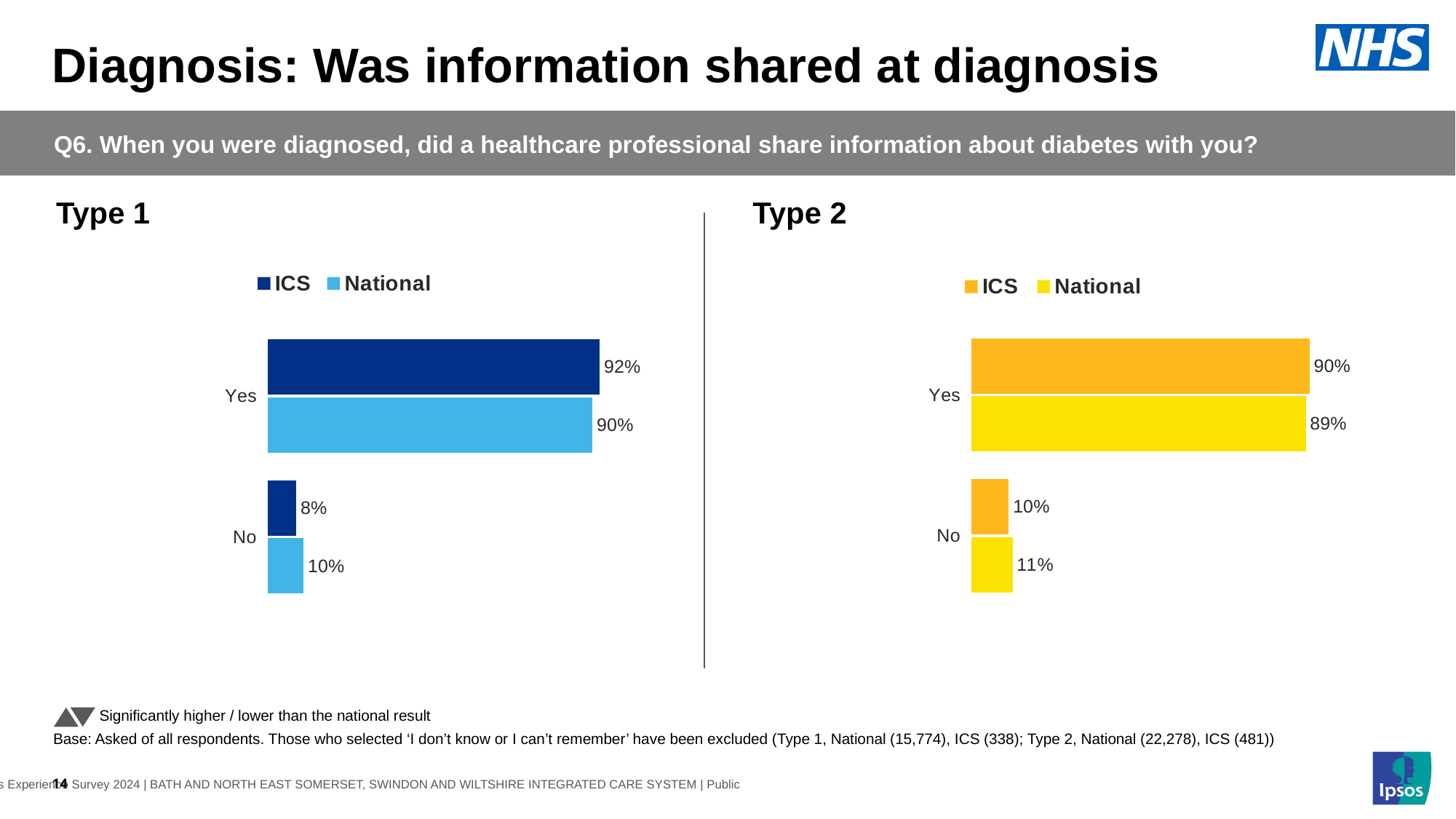
In the Type 1 chart, what is the National value for No? 10% In the Type 2 chart, what is the difference between the National and ICS values for No? 1 percentage point How many categories are shown in the Type 1 chart? 2 In the Type 1 chart, what is the difference between the ICS and National values for Yes? 2 percentage points How many series does the legend of the Type 2 chart list? 2 In the Type 2 chart, what is the ICS value for Yes? 90% In the Type 1 chart, what is the ICS value for Yes? 92% In the Type 2 chart, which is larger for Yes: the ICS value or the National value? ICS In the Type 1 chart, which category has the lowest ICS value? No What kind of chart is the Type 2 chart? Bar chart In the Type 2 chart, what is the National value for No? 11% In the Type 1 chart, which is larger for No: the ICS value or the National value? National